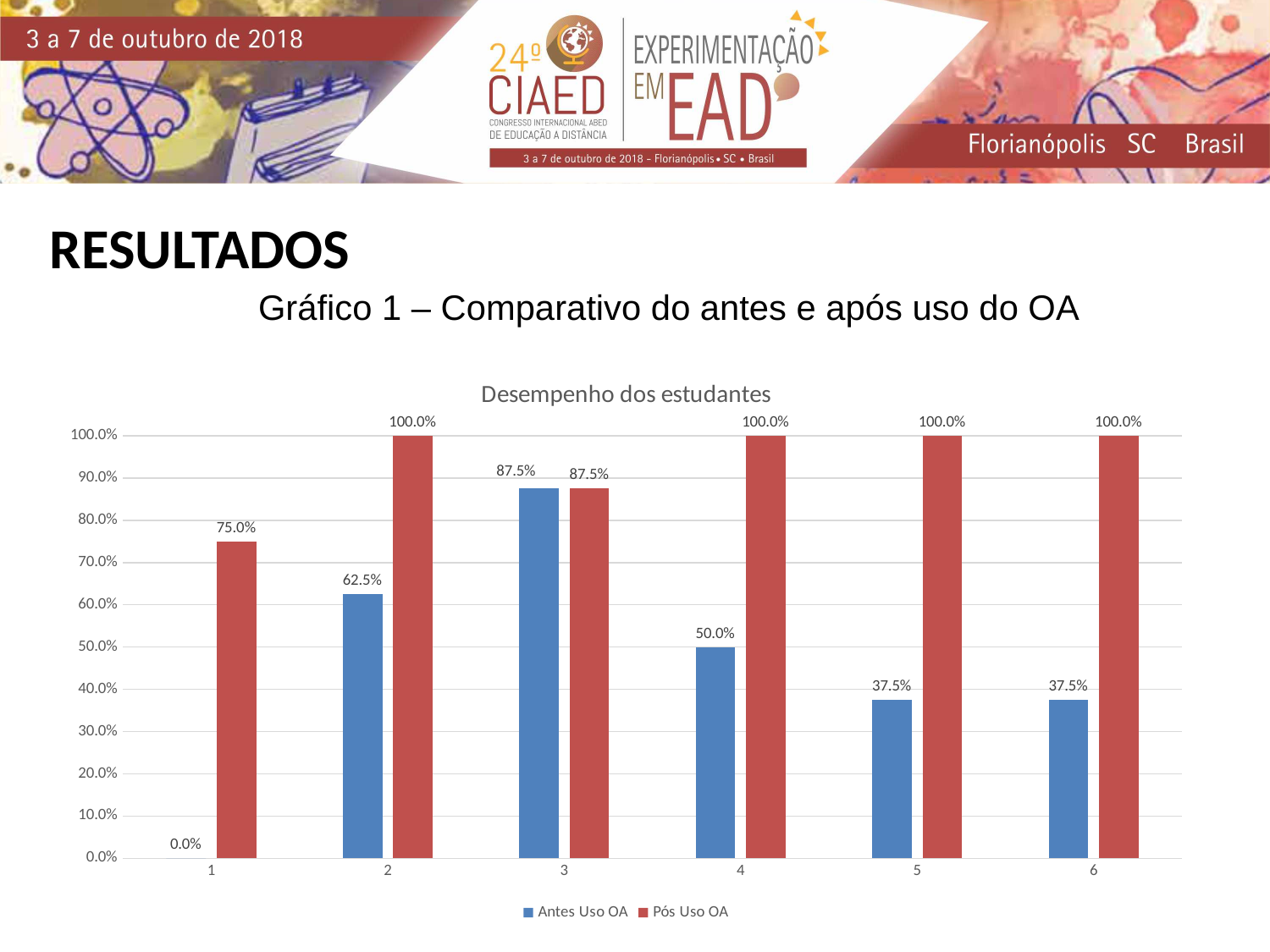
What is the value for Antes Uso OA for category 4? 50.0% Which is larger for category 4, Antes Uso OA or Pós Uso OA? Pós Uso OA How many series does the legend list? 2 What is the value for Antes Uso OA for category 2? 62.5% Which category has the highest value for Antes Uso OA? 3 Which category has the lowest value for Antes Uso OA? 1 What is the difference between Pós Uso OA and Antes Uso OA for category 5? 62.5% What is the value for Pós Uso OA for category 1? 75.0% What is the difference between Pós Uso OA and Antes Uso OA for category 2? 37.5% What is the title of the chart? Desempenho dos estudantes How many categories are shown on the x axis? 6 What kind of chart is shown? bar chart